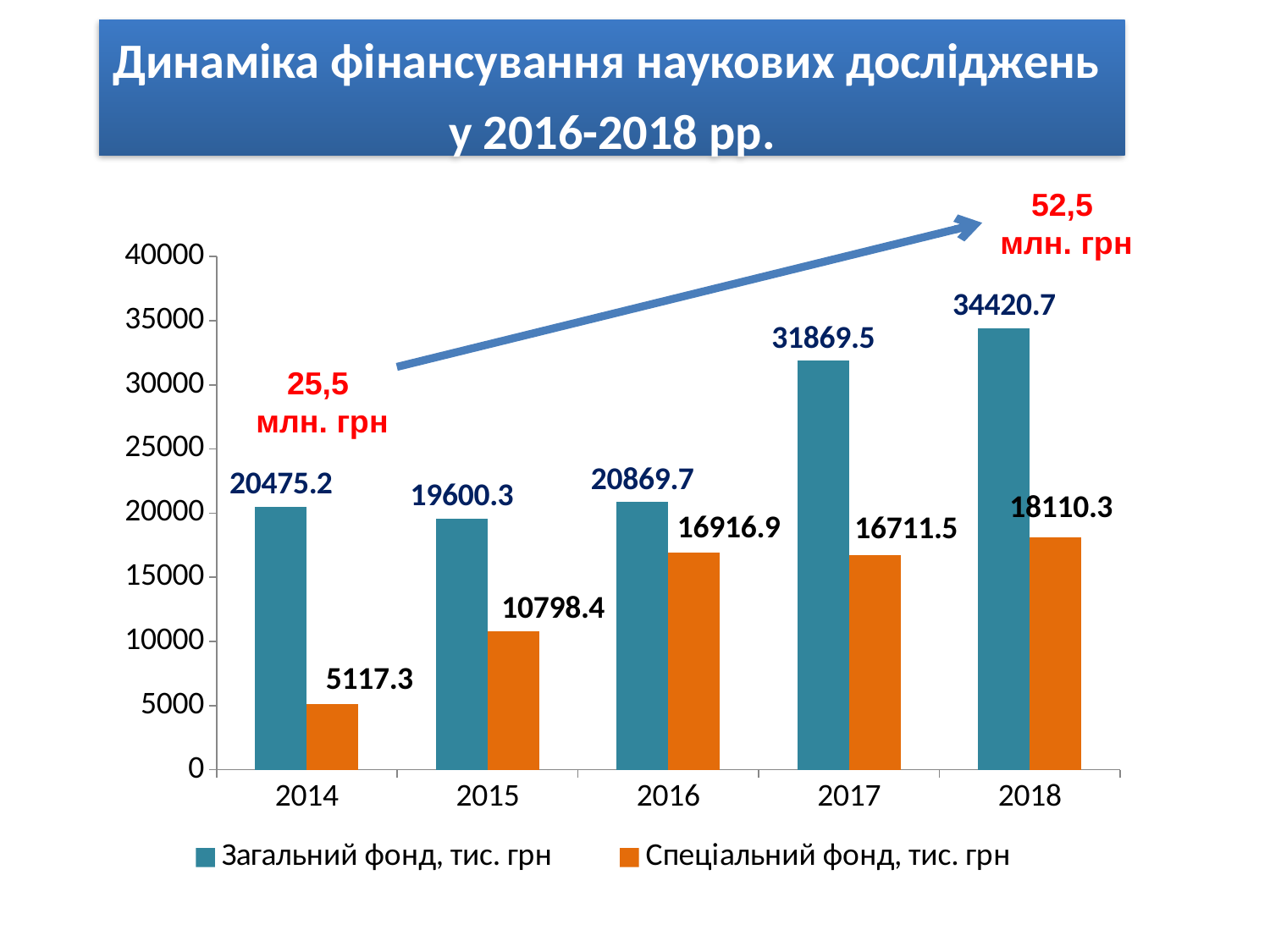
How many series does the legend list? 2 By how much did Загальний фонд, тис. грн increase from 2017 to 2018? 2551.2 What type of chart is shown on the slide? Bar chart What is the value of Спеціальний фонд, тис. грн for 2016? 16916.9 In which year is Загальний фонд, тис. грн the highest? 2018 How many years are shown on the x axis? 5 What is the value of Загальний фонд, тис. грн for 2015? 19600.3 In which year is Спеціальний фонд, тис. грн the lowest? 2014 What is the value of Загальний фонд, тис. грн for 2018? 34420.7 What is the value of Спеціальний фонд, тис. грн for 2014? 5117.3 Which is larger in 2017: Загальний фонд or Спеціальний фонд? Загальний фонд What is the difference between Загальний фонд and Спеціальний фонд in 2018? 16310.4